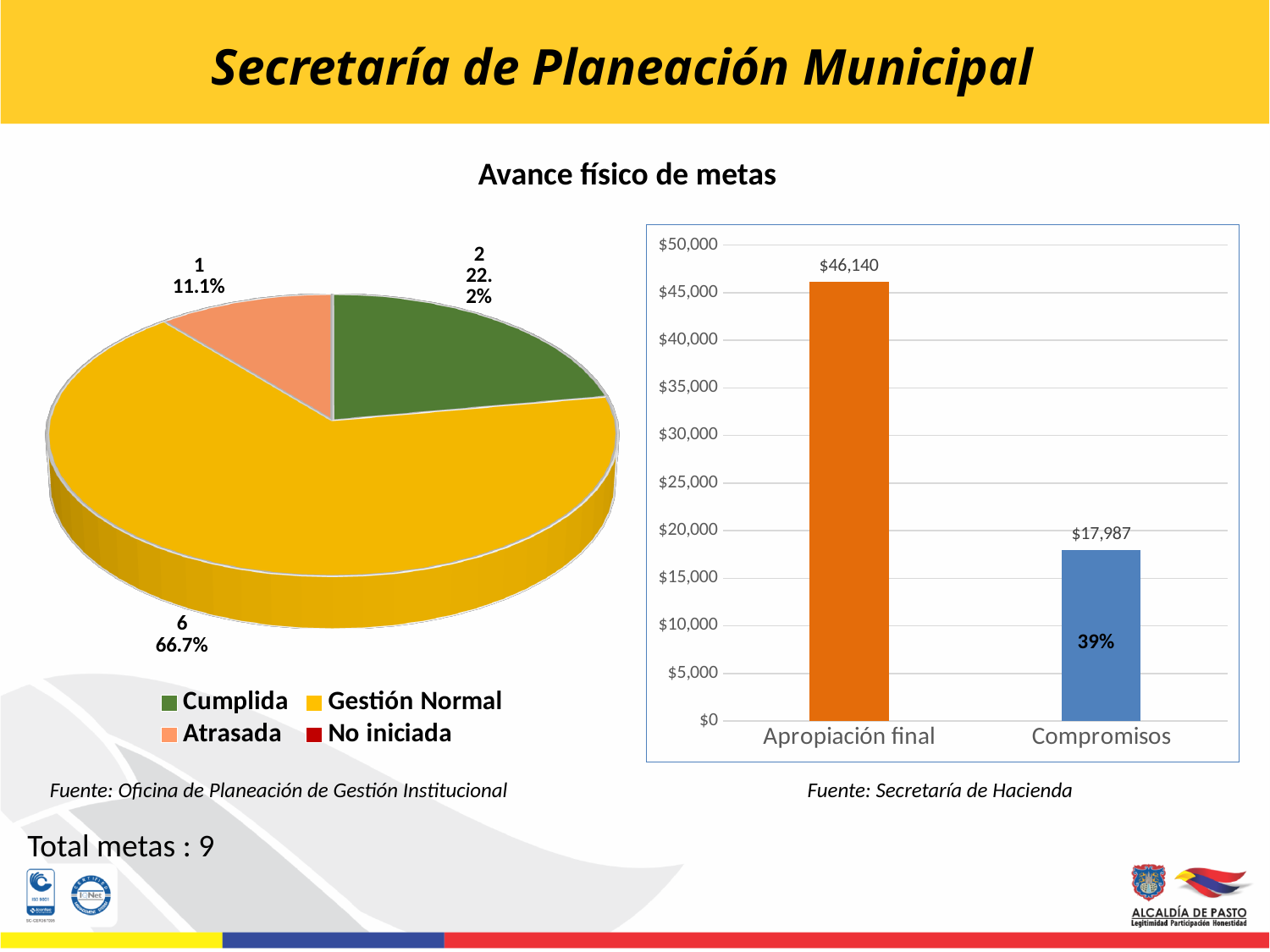
On the bar chart on the right, which is larger, Apropiación final or Compromisos? Apropiación final What kind of chart is shown on the right side of the slide? Bar chart On the pie chart on the left, what percentage share does the Atrasada slice have? 11.1% On the bar chart on the right, what is the difference between Apropiación final and Compromisos? $28,153 On the bar chart on the right, what is the value for Apropiación final? $46,140 On the bar chart on the right, what is the value for Compromisos? $17,987 On the pie chart on the left, what colour is the Cumplida slice? Green On the bar chart on the right, what percentage is printed on the Compromisos bar? 39% On the pie chart on the left, what percentage share does the Cumplida slice have? 22.2% On the pie chart on the left, how many entries does the legend list? 4 On the pie chart on the left, how many metas are in the Gestión Normal category? 6 On the pie chart on the left, which category has the largest slice? Gestión Normal